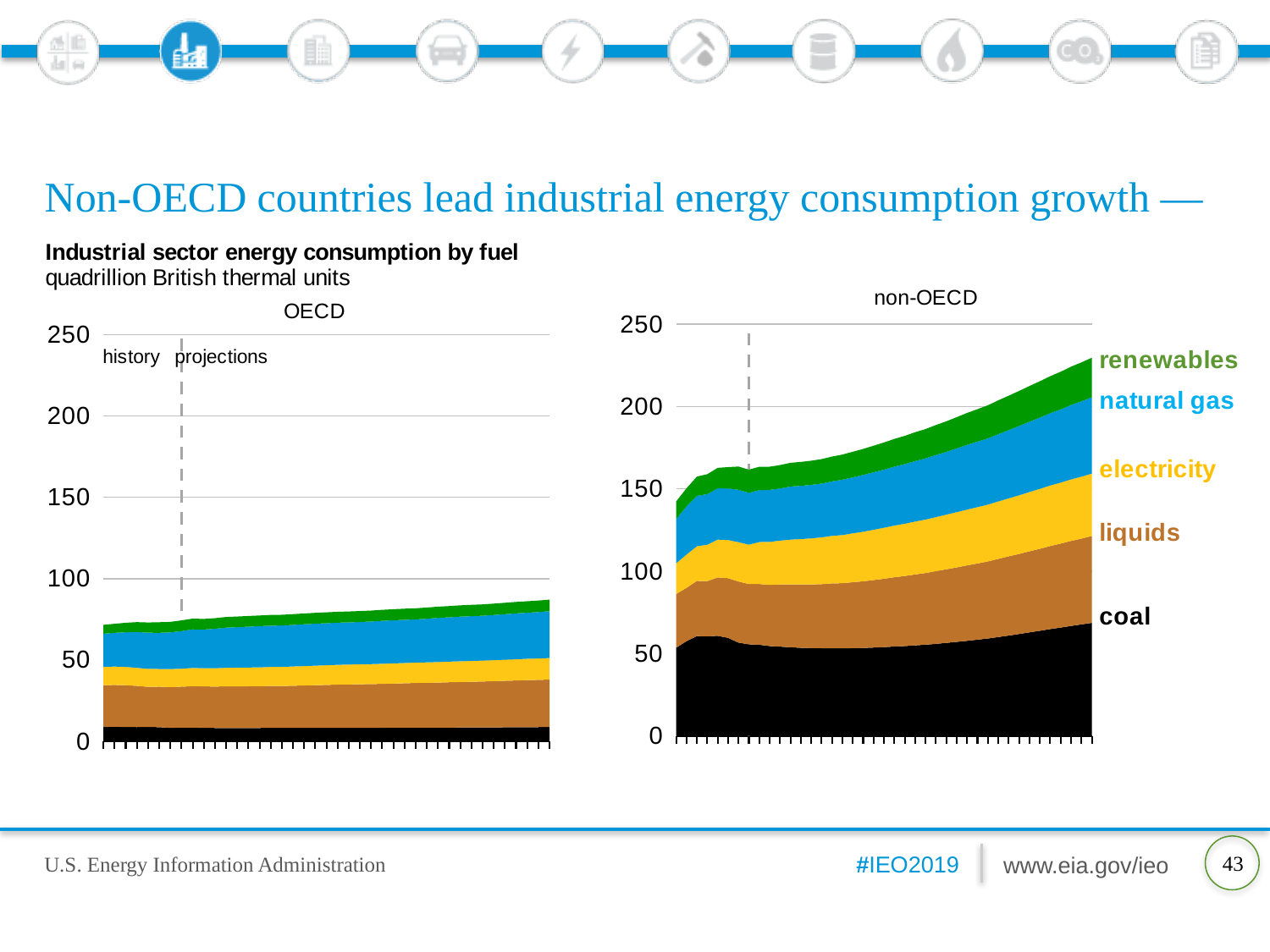
How many fuel series are labelled on the non-OECD chart? 5 On the non-OECD chart, which fuel is the largest single component at the end of the projection period? coal On the non-OECD chart, which fuel is the smallest component at the end of the projection period? renewables What kind of chart is the OECD chart? stacked area chart At the end of the projection period, which region has the larger total industrial energy consumption, OECD or non-OECD? non-OECD On the non-OECD chart, is coal consumption at the end of the projection period greater or less than 50? greater On the non-OECD chart, is the total consumption at the end of the projection period greater or less than 200? greater On the non-OECD chart, does total industrial energy consumption rise or fall over the projection period? rise On the non-OECD chart, is the total consumption at the start of the history period greater or less than 150? less What unit of measurement is used for the charts on this slide? quadrillion British thermal units Which fuel series is stacked at the bottom of the non-OECD chart? coal